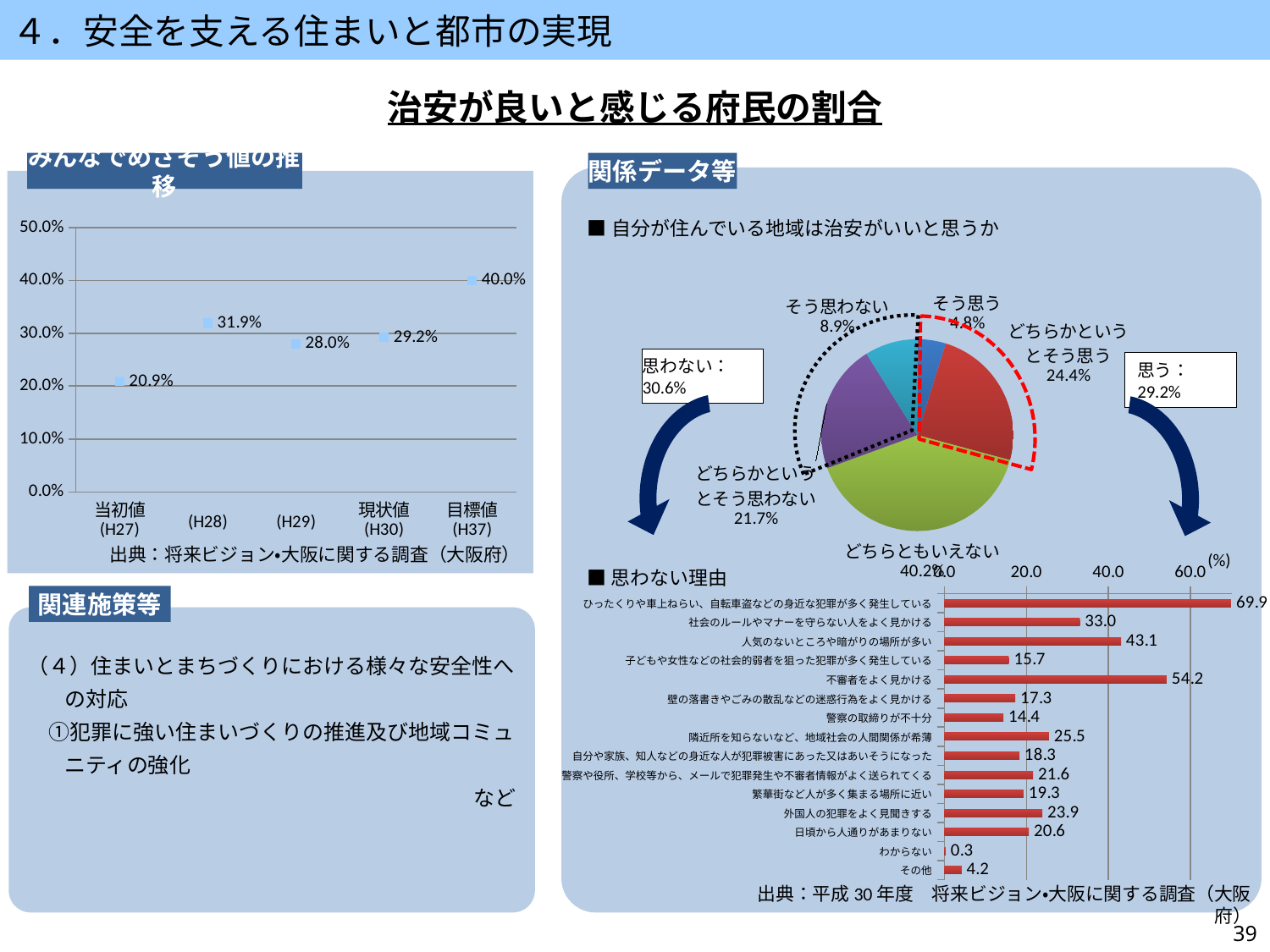
In the chart titled みんなでめざそう値の推移, what is the value for 目標値 (H37)? 40.0% In the bar chart 思わない理由, what is the value for 不審者をよく見かける? 54.2 In the chart titled みんなでめざそう値の推移, what is the value for 当初値 (H27)? 20.9% In the pie chart 自分が住んでいる地域は治安がいいと思うか, which is larger: どちらかというとそう思う or どちらかというとそう思わない? どちらかというとそう思う In the bar chart 思わない理由, which category has the highest value? ひったくりや車上ねらい、自転車盗などの身近な犯罪が多く発生している In the chart titled みんなでめざそう値の推移, which category has the lowest value? 当初値 (H27) In the pie chart 自分が住んでいる地域は治安がいいと思うか, what share is そう思う? 4.8% In the chart titled みんなでめざそう値の推移, what is the difference between the value for (H28) and the value for (H29)? 3.9% In the pie chart 自分が住んでいる地域は治安がいいと思うか, what share is どちらともいえない? 40.2% In the chart titled みんなでめざそう値の推移, how many data points are plotted? 5 In the pie chart 自分が住んでいる地域は治安がいいと思うか, which slice is the largest? どちらともいえない What kind of chart is the 思わない理由 chart? bar chart